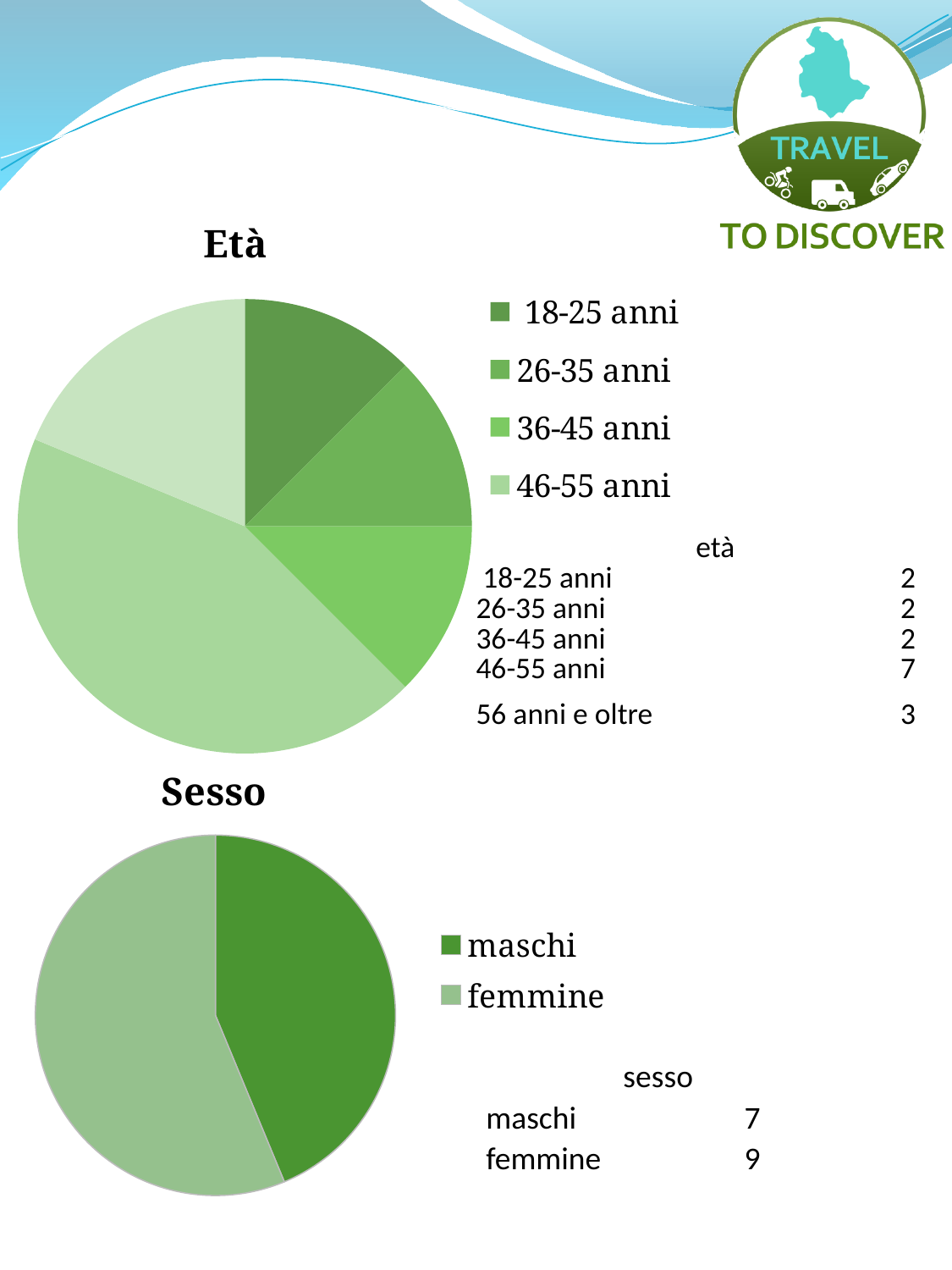
How many slices does the 'Età' pie chart have? 5 In the 'Età' chart, what is the value for 46-55 anni? 7 In the 'Sesso' chart, which is larger, maschi or femmine? femmine In the 'Età' chart, what is the total of all the age group values? 16 In the 'Sesso' chart, what is the value for maschi? 7 In the 'Età' chart, which age group has the largest value? 46-55 anni In the 'Sesso' chart, what is the difference between femmine and maschi? 2 What are the two legend entries of the 'Sesso' chart? maschi, femmine In the 'Età' chart, what is the difference between the values for 46-55 anni and 56 anni e oltre? 4 In the 'Età' chart, what is the value for 56 anni e oltre? 3 What kind of chart is the 'Età' chart? pie chart In the 'Sesso' chart, what is the value for femmine? 9